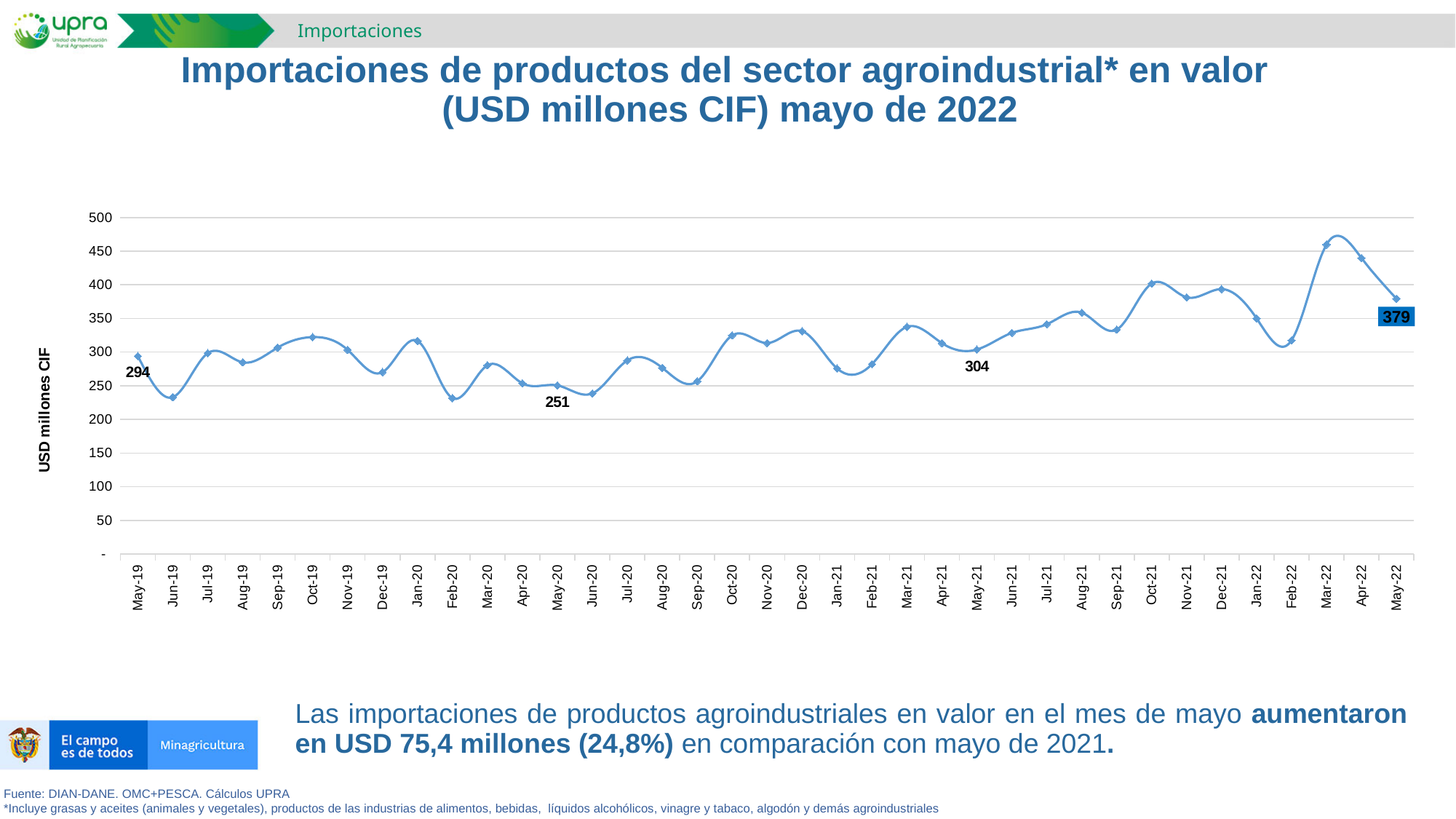
What is the value for May-21? 304 Is the value for Feb-20 greater or less than 250? less Which month has the highest value on the chart? Mar-22 What is the value for May-22? 379 What is the difference between the values for May-19 and May-20? 43 What type of chart is shown on the slide? line chart What is the difference between the values for May-22 and May-21? 75 Which is larger, the value for May-21 or the value for May-20? May-21 What is the value for May-19? 294 What is the value for May-20? 251 What is the label of the vertical axis? USD millones CIF Is the value for Oct-21 greater or less than 350? greater